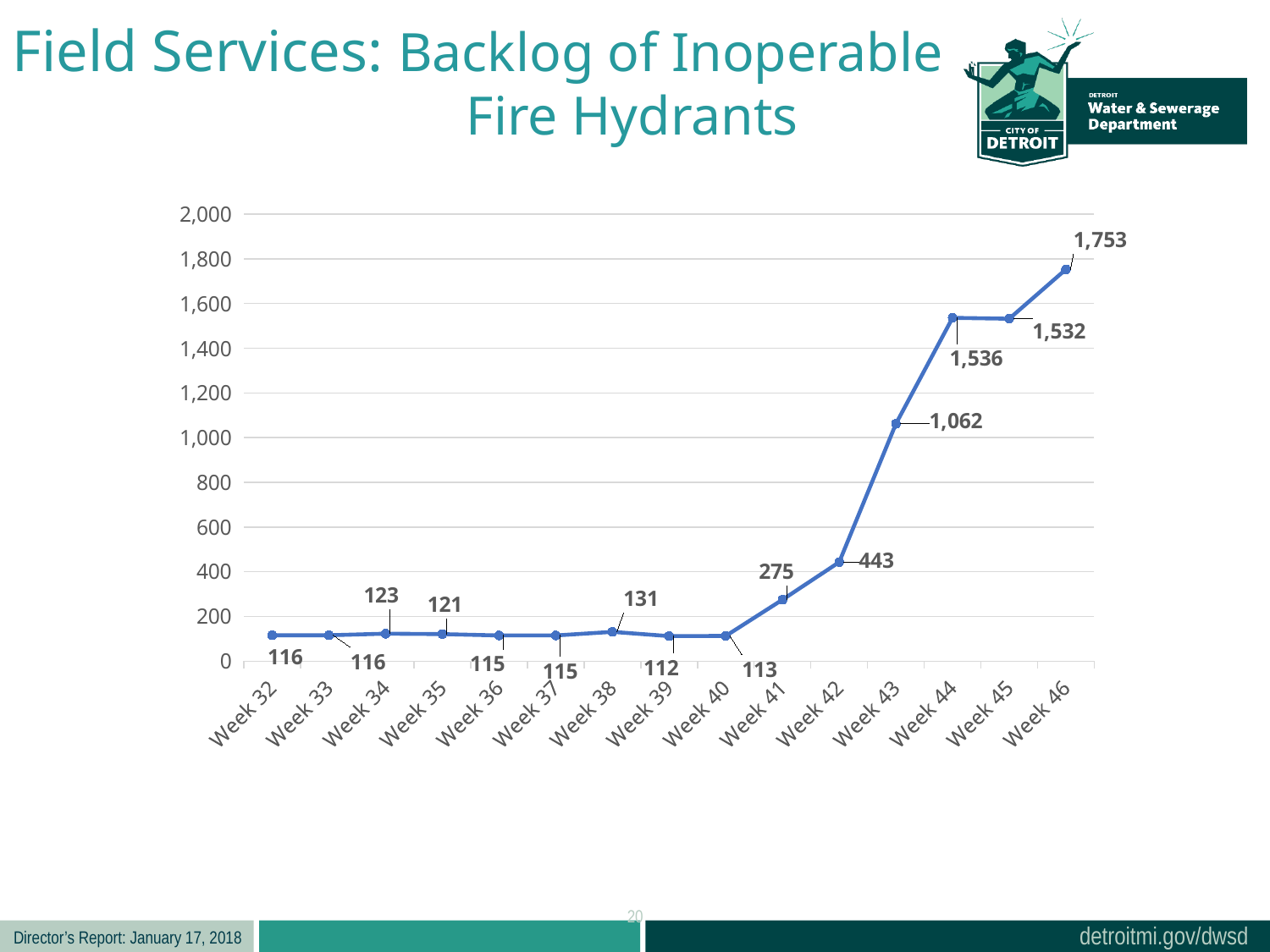
How many weeks are plotted on the chart? 15 Which week has the highest backlog of inoperable fire hydrants? Week 46 Which week has the lowest backlog of inoperable fire hydrants? Week 39 Which is larger, the backlog in Week 44 or Week 45? Week 44 What is the title of the slide containing the chart? Field Services: Backlog of Inoperable Fire Hydrants Does the backlog rise or fall from Week 40 to Week 46? Rise What kind of chart is shown on the slide? Line chart What is the backlog of inoperable fire hydrants in Week 46? 1,753 What is the backlog value shown for Week 43? 1,062 What is the backlog value shown for Week 41? 275 What is the difference between the backlog in Week 44 and Week 43? 474 Is the backlog value for Week 42 greater or less than 400? greater